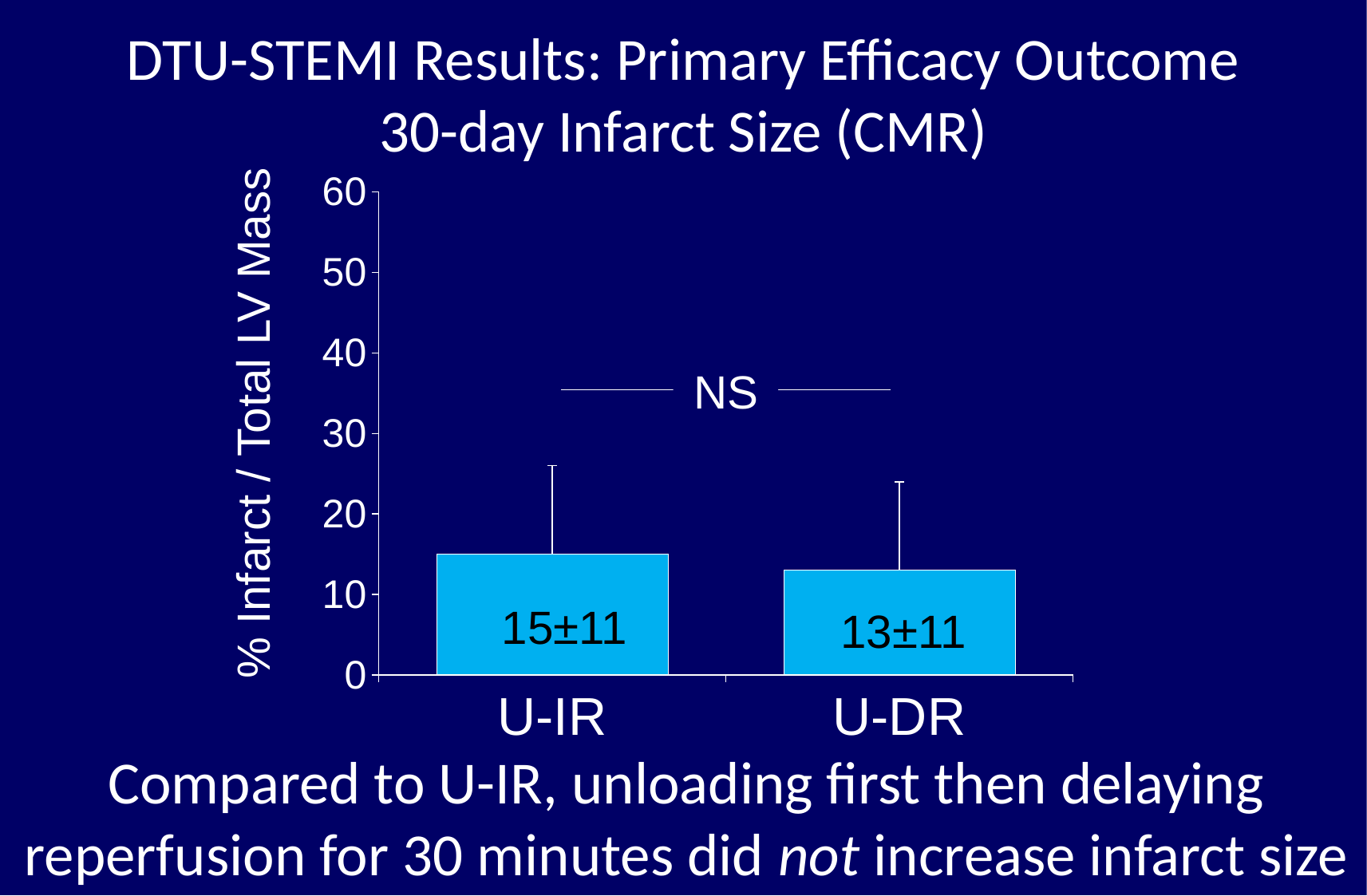
What is the label of the y axis? % Infarct / Total LV Mass Which category has the higher infarct size? U-IR What is the value shown for U-DR? 13±11 What is the difference between the mean values for U-IR and U-DR? 2 Is the mean value for U-DR greater or less than 20? less What is the value shown for U-IR? 15±11 Which category has the lower infarct size? U-DR What kind of chart is shown on the slide? bar chart Is the mean value for U-IR greater or less than 10? greater What annotation is shown between the two bars indicating the statistical comparison? NS Is the mean value for U-IR larger or smaller than the mean value for U-DR? larger How many categories are shown on the x axis? 2